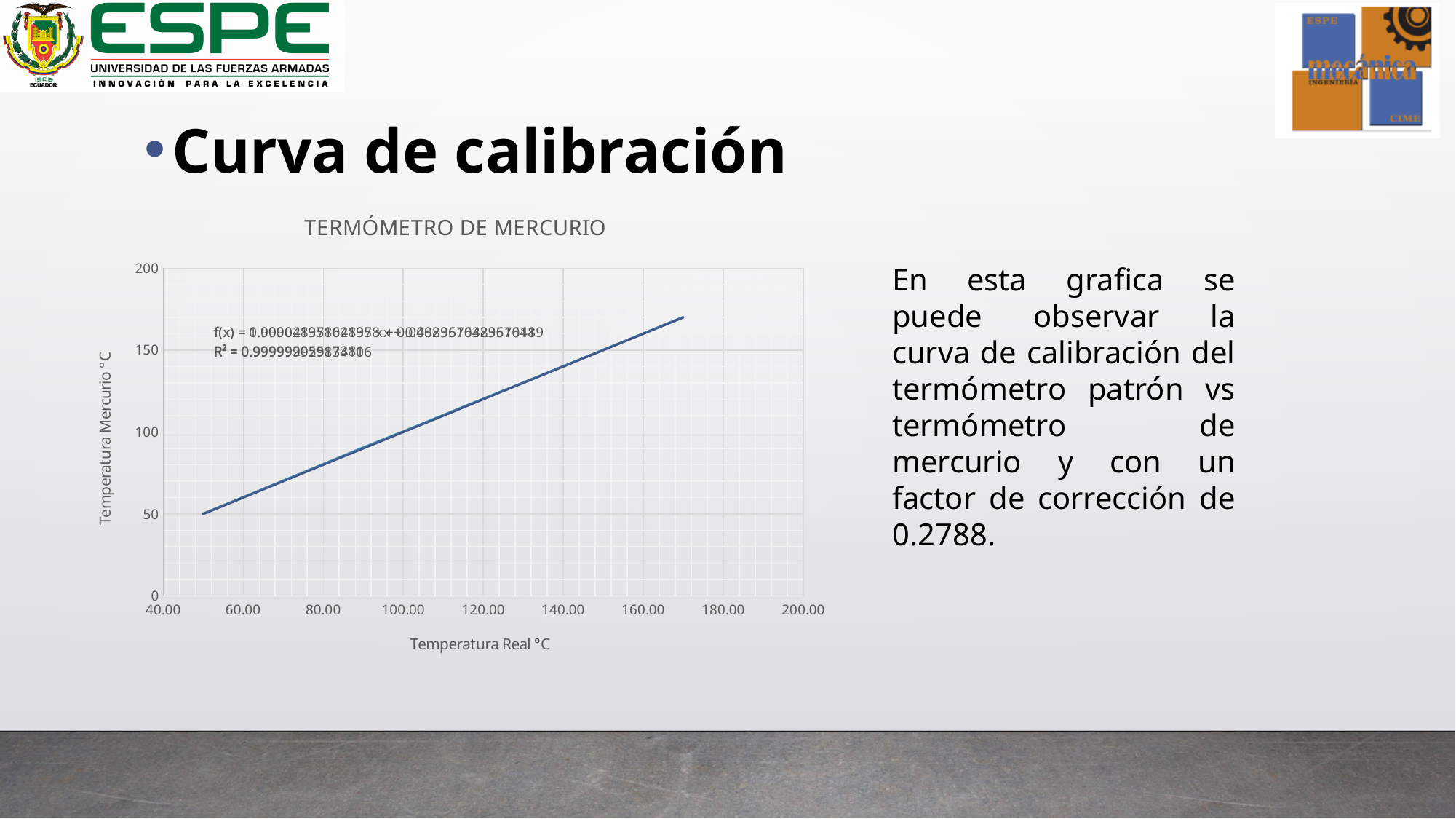
What kind of chart is shown on the slide? line chart Do the values of Temperatura Mercurio rise or fall as Temperatura Real increases along the x axis? rise Which has the larger Temperatura Mercurio value: a Temperatura Real of 80.00 or of 160.00? 160.00 Is the Temperatura Mercurio value at a Temperatura Real of 160.00 greater or less than 150? greater Is the Temperatura Mercurio value at a Temperatura Real of 60.00 greater or less than 100? less Is the Temperatura Mercurio value at a Temperatura Real of 140.00 greater or less than 100? greater What is the label of the x axis of the chart? Temperatura Real °C What is the title of the chart on the slide? TERMÓMETRO DE MERCURIO